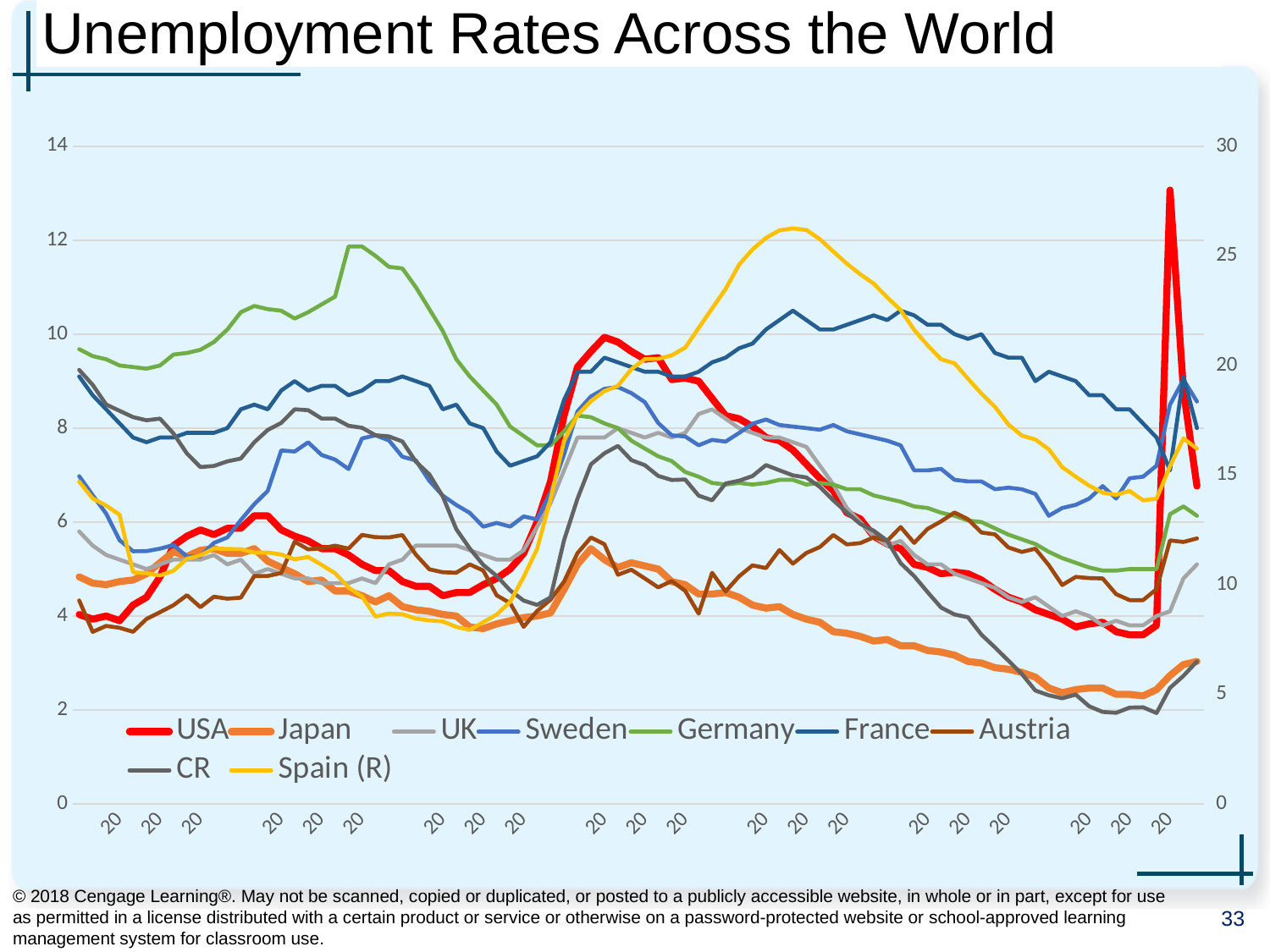
Is the peak value of the Spain (R) line greater or less than 20 on the right axis? greater Is the peak value of the Germany line greater or less than 10 on the left axis? greater Which series in the legend is marked as plotted on the right axis? Spain (R) What is the title of the chart? Unemployment Rates Across the World Is the lowest value of the CR line greater or less than 4 on the left axis? less How many series does the legend list? 9 Does the Germany line generally rise or fall over the right half of the chart? fall What is the maximum value shown on the right vertical axis? 30 Which series reaches the highest value on the left axis? USA What kind of chart is shown on the slide? line chart